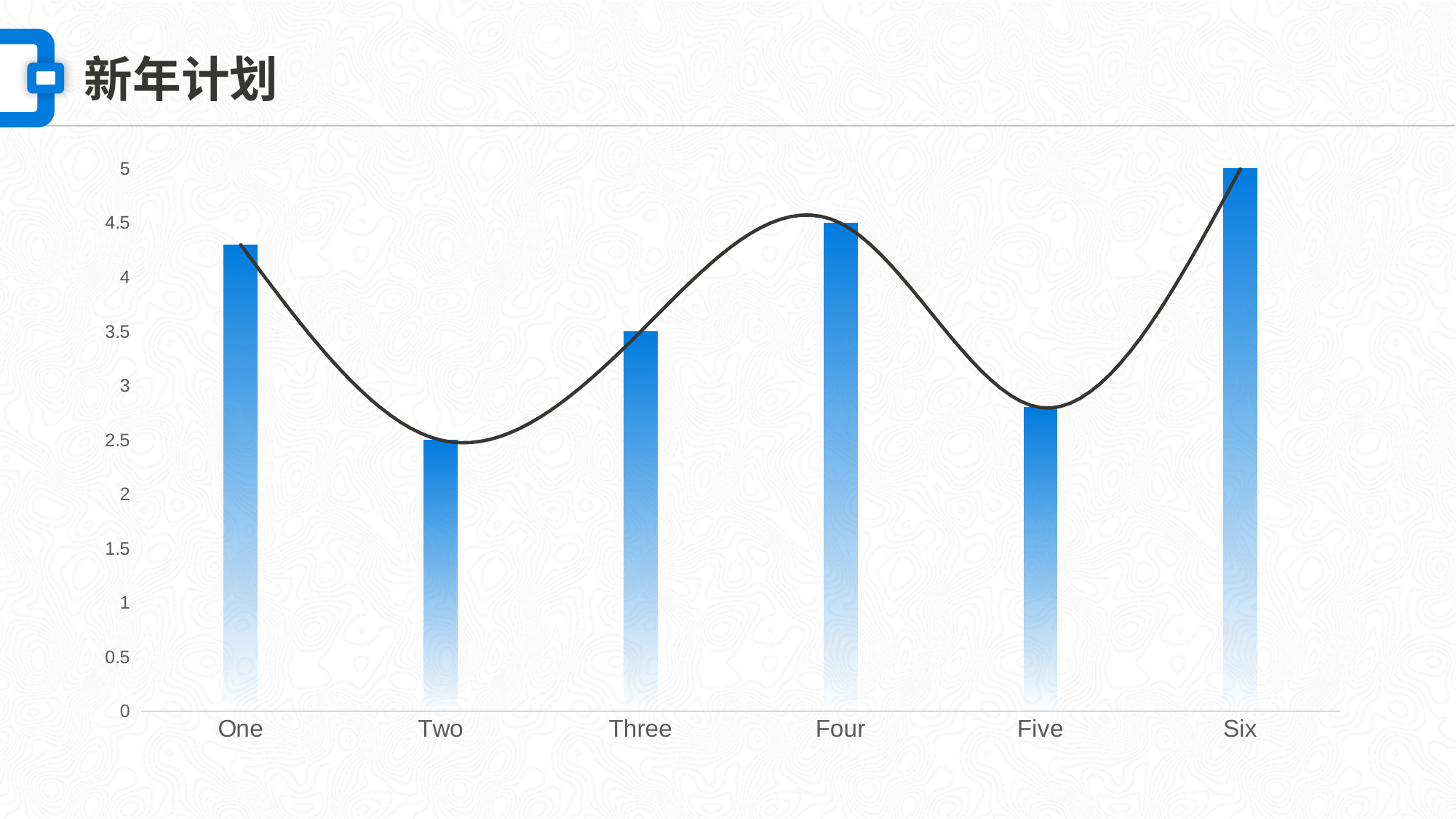
What is the value for Six? 5 Which category has the highest value? Six Is the value for One greater or less than 4? greater What is the value for Four? 4.5 What is the value for Three? 3.5 Which is larger, the value for One or the value for Three? One Is the value for Five greater or less than 3? less Do the values rise or fall from Two to Four? rise What is the difference between the values for Six and Two? 2.5 Which category has the lowest value? Two What is the value for Two? 2.5 How many categories are shown on the x axis? 6